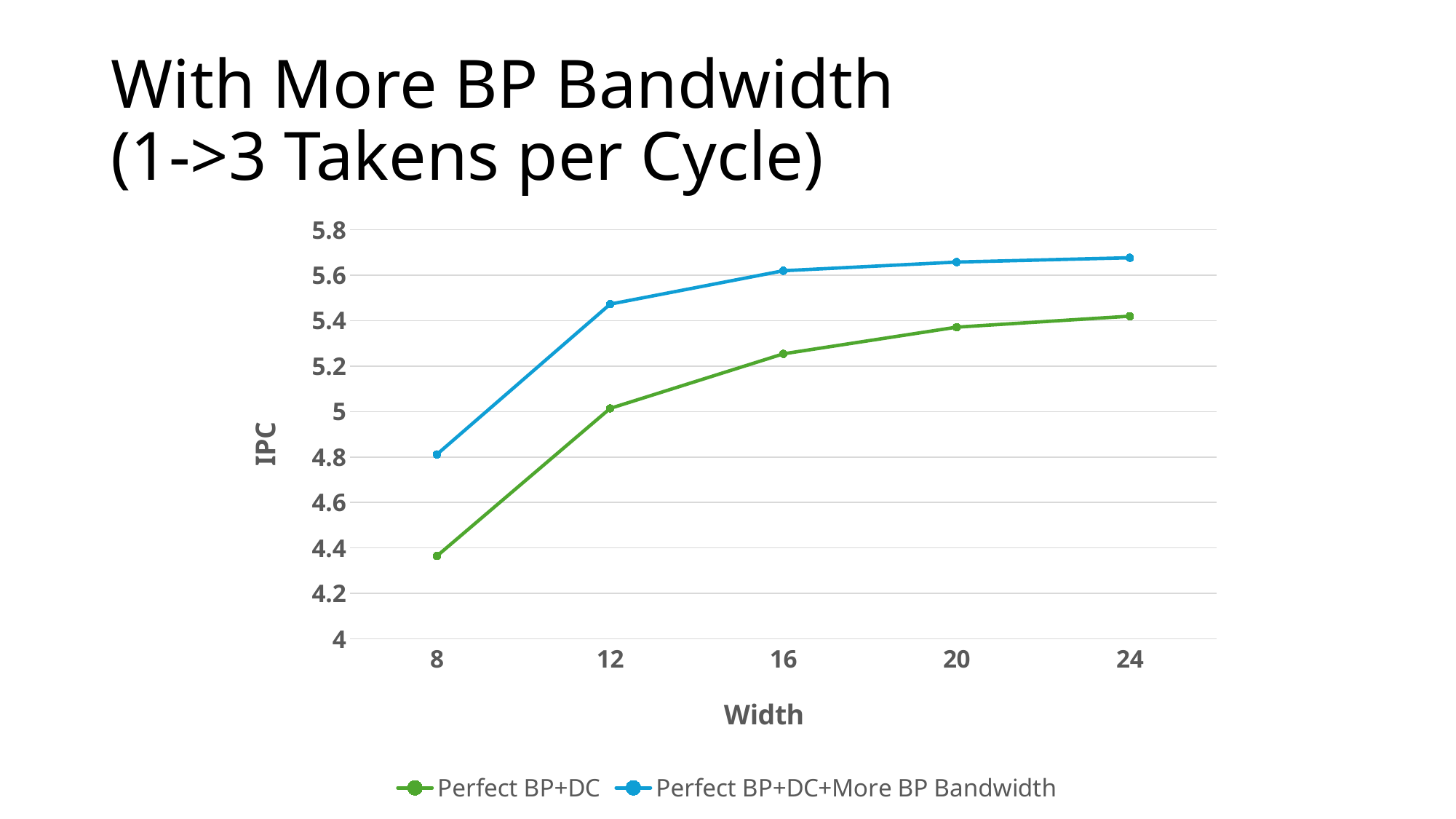
At which Width is the IPC for Perfect BP+DC+More BP Bandwidth highest? 24 At which Width is the IPC for Perfect BP+DC lowest? 8 Is the IPC for Perfect BP+DC at Width 8 greater or less than 4.6? less How many series does the legend list? 2 Is the IPC for Perfect BP+DC+More BP Bandwidth at Width 12 greater or less than 5.4? greater What kind of chart is shown on the slide? line chart At Width 16, which series has the higher IPC, Perfect BP+DC or Perfect BP+DC+More BP Bandwidth? Perfect BP+DC+More BP Bandwidth What is the label of the y axis? IPC Which series is plotted in blue? Perfect BP+DC+More BP Bandwidth How many width values are plotted along the x axis? 5 Is the IPC for Perfect BP+DC at Width 24 greater or less than 5.6? less Does the IPC for Perfect BP+DC rise or fall as Width increases from 8 to 24? rise